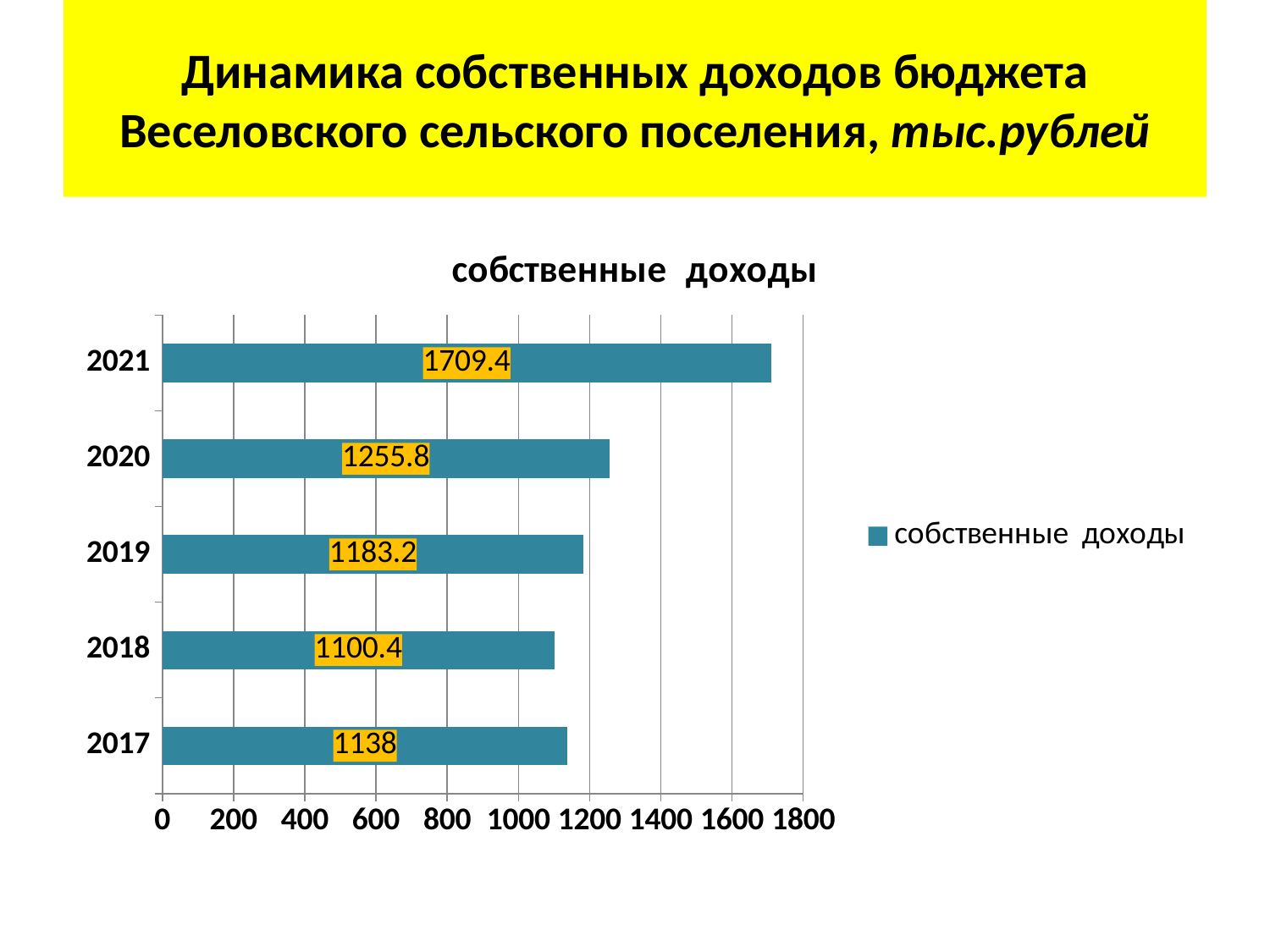
What is the title of the chart? собственные доходы What kind of chart is shown on the slide? bar chart What is the value for 2021? 1709.4 What is the difference between the values for 2021 and 2020? 453.6 What is the difference between the values for 2019 and 2018? 82.8 Is the value for 2021 greater or less than 1600? greater Which year has the lowest value? 2018 Which year has the highest value? 2021 How many years are shown in the chart? 5 Which is larger, the value for 2020 or the value for 2019? 2020 What is the value for 2017? 1138 What is the value for 2018? 1100.4